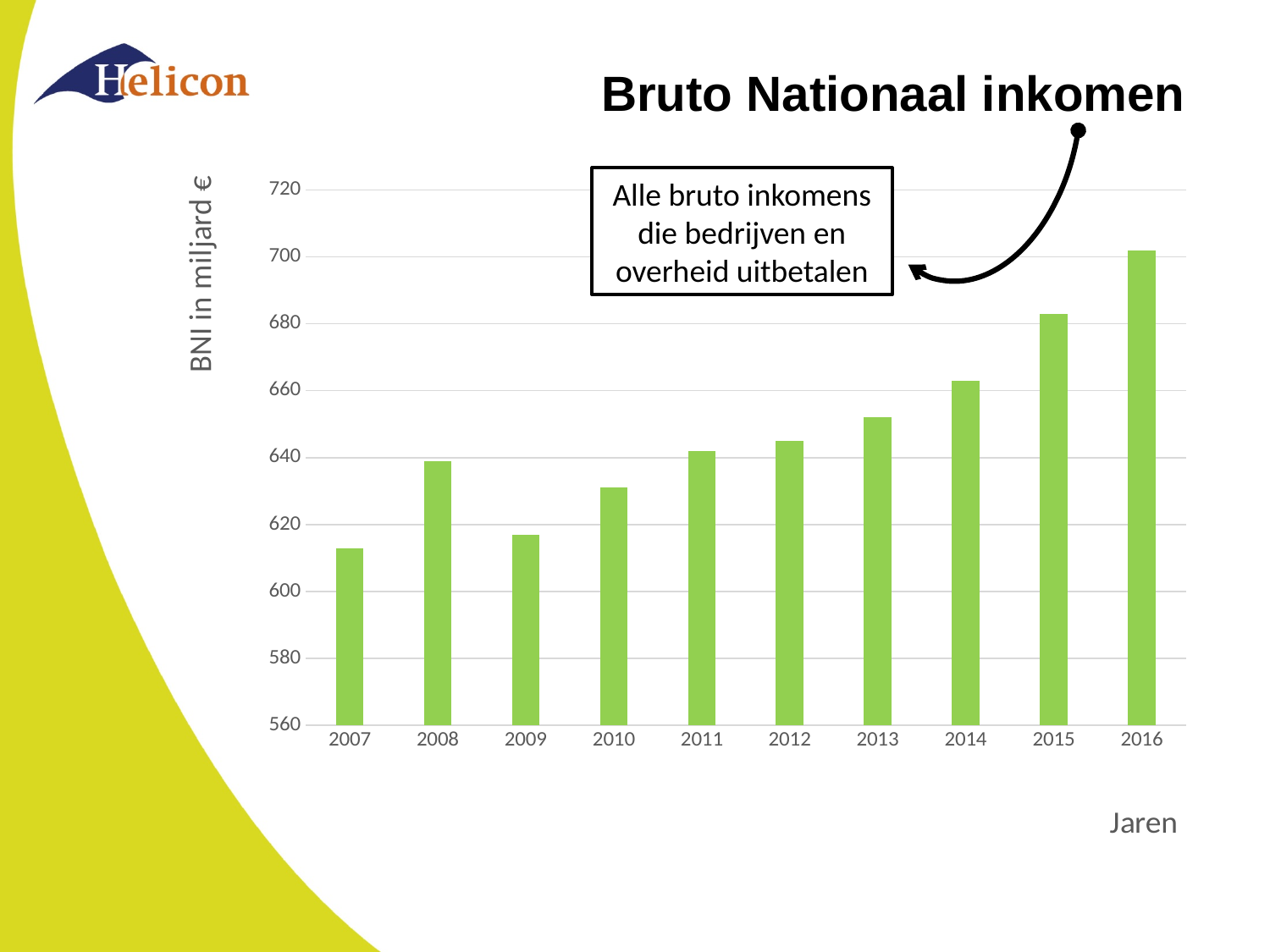
What is the label on the vertical axis of the chart? BNI in miljard € Is the value for 2007 greater or less than 620? less Which year has the highest value in the chart? 2016 What is the title of the chart? Bruto Nationaal inkomen Is the value for 2013 greater or less than 660? less Is the value for 2010 greater or less than 620? greater Do the values generally rise or fall from 2009 to 2016? rise Which is larger, the value for 2008 or the value for 2009? 2008 What kind of chart is shown on the slide? bar chart How many years are shown on the x axis of the chart? 10 Which is larger, the value for 2014 or the value for 2015? 2015